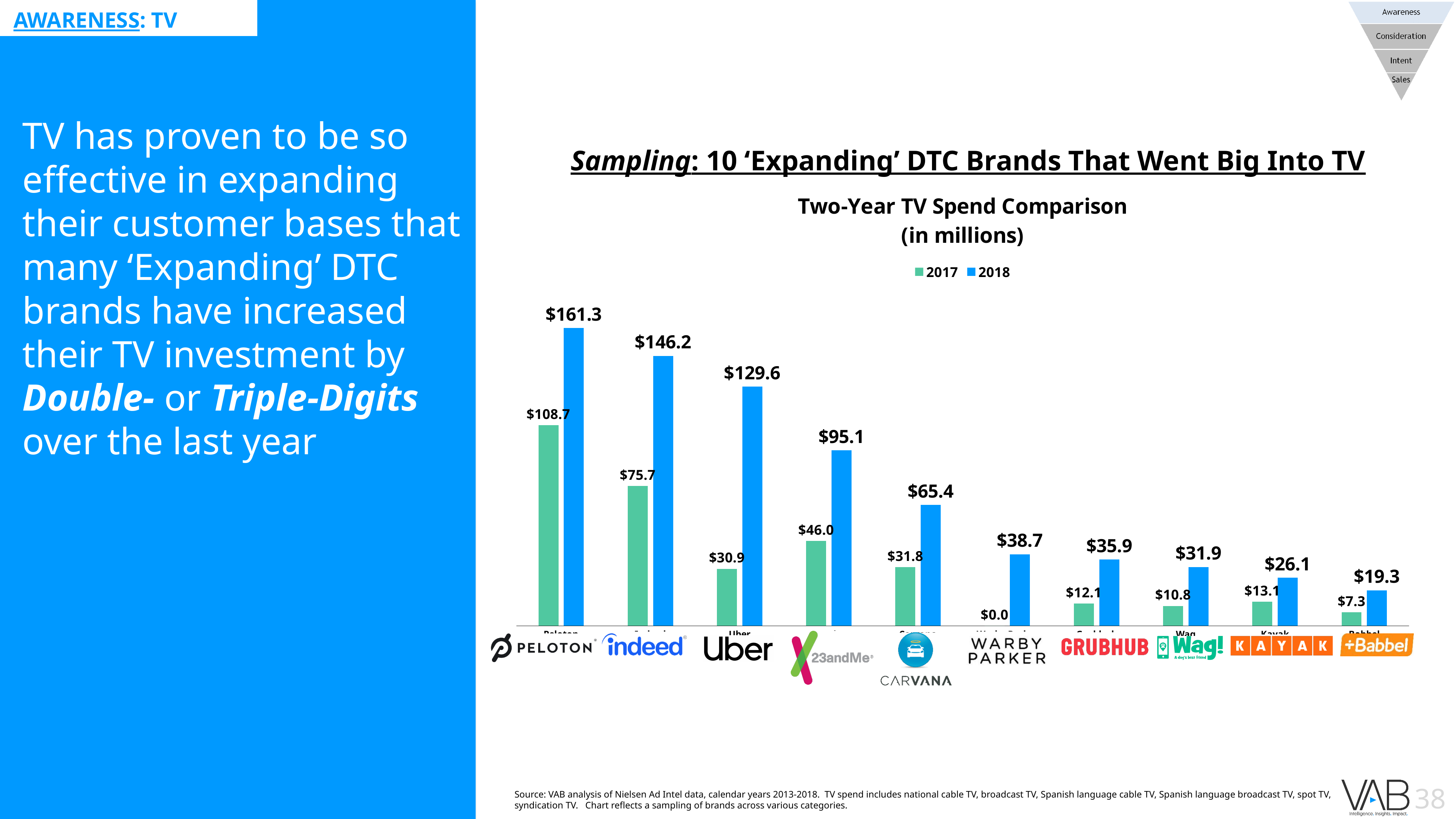
What kind of chart is shown? Bar chart What is the difference between Uber's 2018 and 2017 TV spend? $98.7 What was Uber's 2017 TV spend? $30.9 How many series does the legend list? 2 Which brand had the lowest 2018 TV spend? Babbel What was Peloton's 2018 TV spend? $161.3 How many brands are shown in the chart? 10 What was Warby Parker's 2017 TV spend? $0.0 What is the difference between Indeed's 2018 and 2017 TV spend? $70.5 Which brand had the highest 2018 TV spend? Peloton Which was larger, Carvana's 2018 TV spend or 23andMe's 2018 TV spend? 23andMe What unit are the values in the chart expressed in? Millions